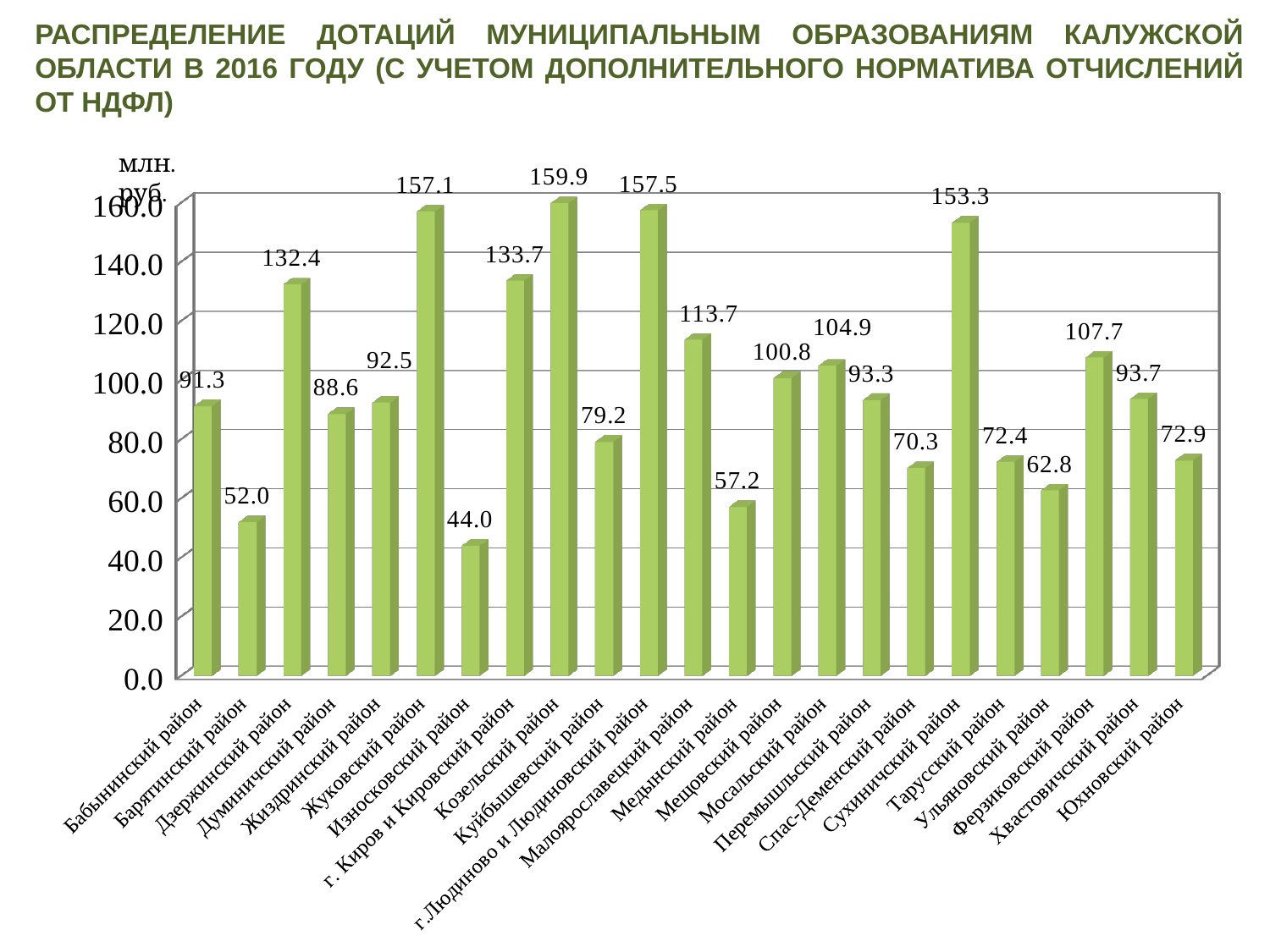
What is the difference between the values for Козельский район and Износковский район? 115.9 Is the value for Ферзиковский район greater or less than 100.0? greater What is the difference between the values for Дзержинский район and Барятинский район? 80.4 How many districts are shown on the chart? 23 What is the value for Малоярославецкий район? 113.7 What is the value for Износковский район? 44.0 Which district has the lowest value? Износковский район What is the value for Сухиничский район? 153.3 What kind of chart is shown on the slide? bar chart Which district has the highest value? Козельский район Which is larger, the value for Жуковский район or the value for Мосальский район? Жуковский район What is the value for Козельский район? 159.9